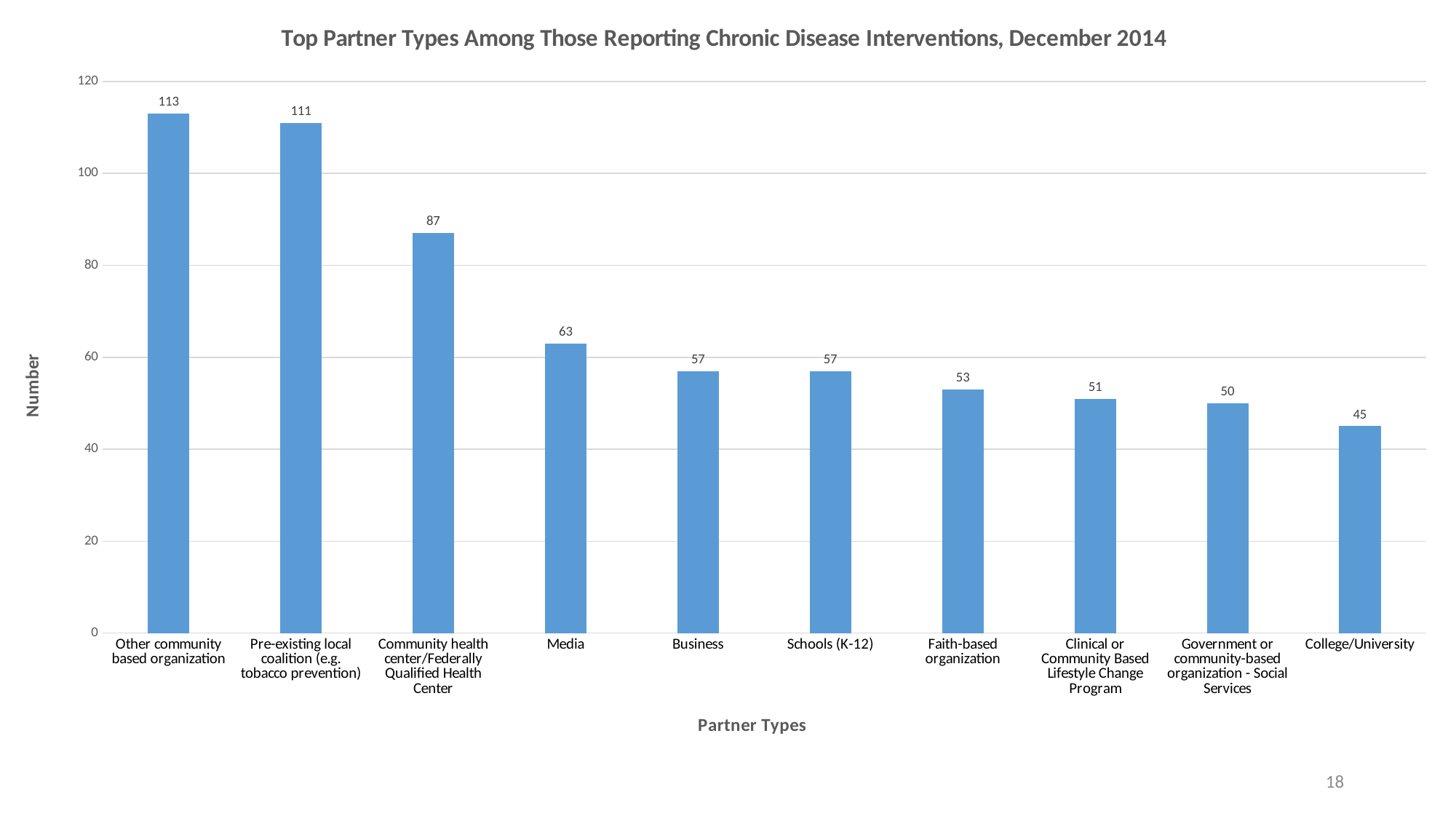
What is the value for Community health center/Federally Qualified Health Center? 87 What kind of chart is shown on the slide? Bar chart How many partner types are shown on the chart? 10 What is the title of the chart? Top Partner Types Among Those Reporting Chronic Disease Interventions, December 2014 What is the difference between the values for Other community based organization and Pre-existing local coalition (e.g. tobacco prevention)? 2 What is the value for Faith-based organization? 53 Is the value for Clinical or Community Based Lifestyle Change Program greater or less than 60? less Which partner type has the lowest value? College/University What is the difference between the values for Media and College/University? 18 Which is larger, the value for Media or the value for Business? Media Which partner type has the highest value? Other community based organization What is the value for Media? 63